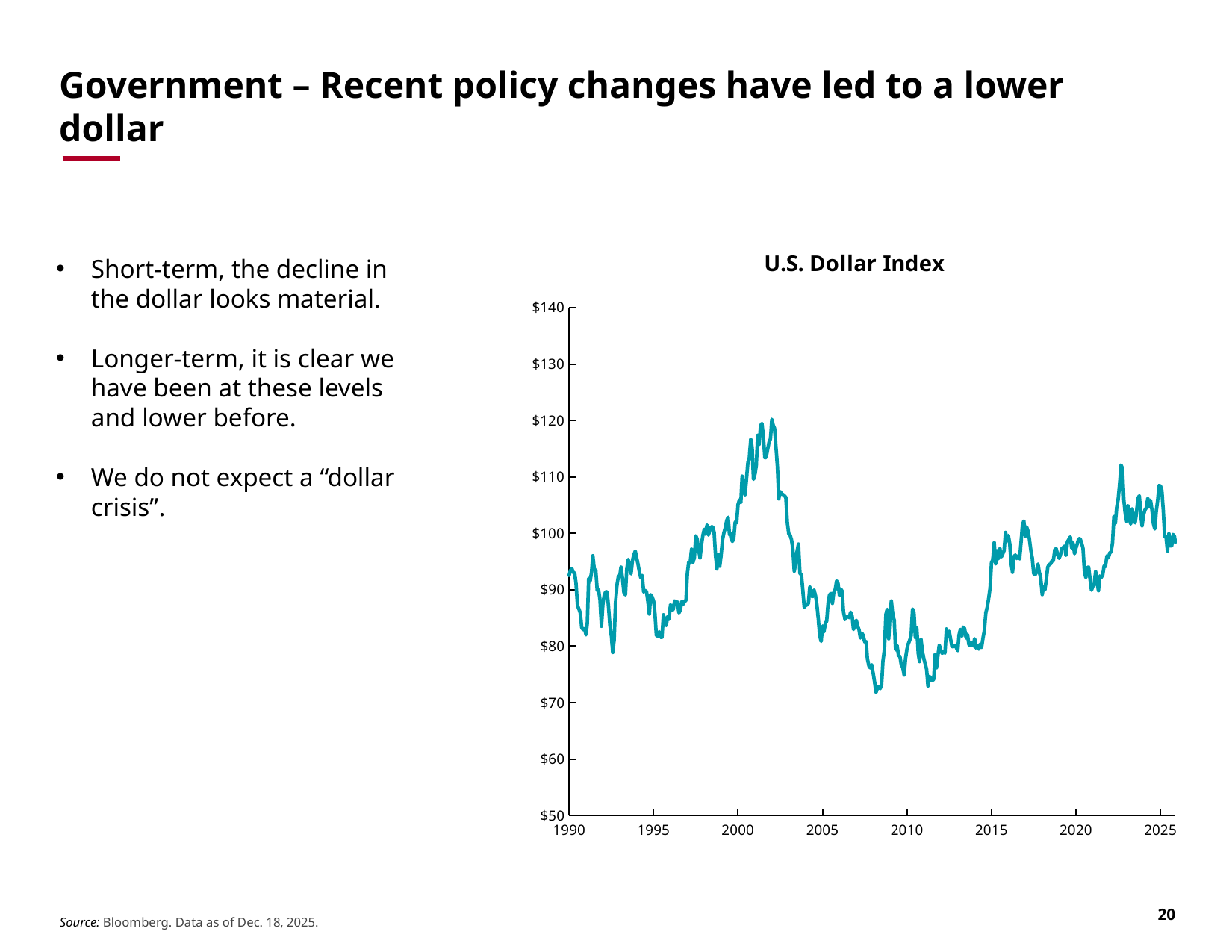
Does the U.S. Dollar Index rise or fall between its peak around 2002 and 2008? fall What is the title of the chart? U.S. Dollar Index Is the value of the U.S. Dollar Index at its peak between 2000 and 2005 greater or less than $110? greater Is the value of the U.S. Dollar Index at the end of the line in 2025 greater or less than $110? less Between which two labelled years on the x axis does the U.S. Dollar Index reach its highest point? 2000 and 2005 How many series are plotted on the chart? 1 Is the value of the U.S. Dollar Index at its lowest point between 2005 and 2010 greater or less than $80? less How many year labels are shown on the x axis? 8 What kind of chart is shown on the slide? line chart Between which two labelled years on the x axis does the U.S. Dollar Index reach its lowest point? 2005 and 2010 What is the highest value labelled on the y axis? $140